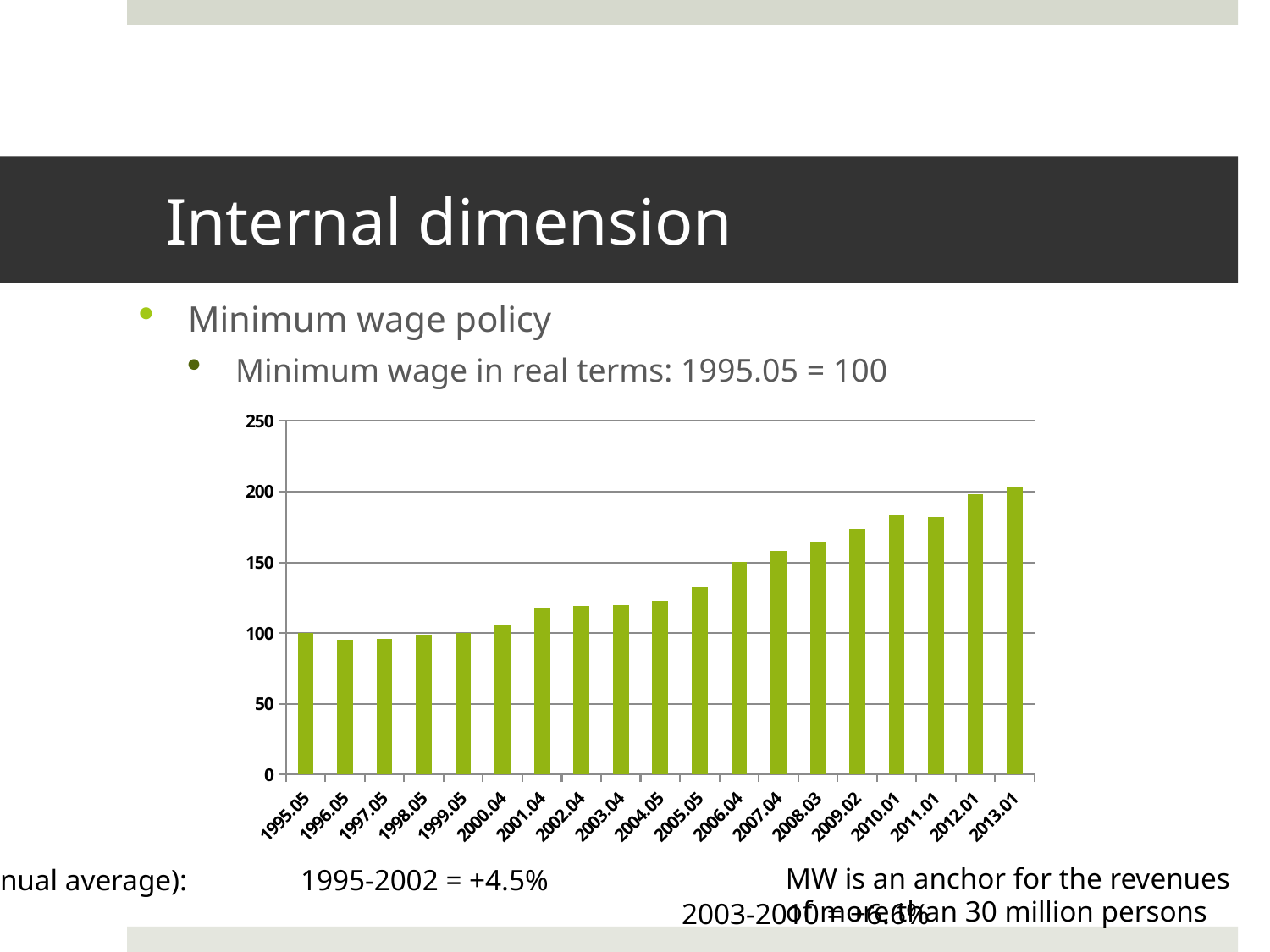
Which time point has the highest bar in the chart? 2013.01 Which is larger, the value for 2008.03 or the value for 2009.02? 2009.02 Which is larger, the value for 2005.05 or the value for 2006.04? 2006.04 Is the value for 2009.02 greater or less than 200? less What is the highest tick value shown on the vertical axis? 250 Is the value for 2005.05 greater or less than 150? less Do the values generally rise or fall from 1995.05 to 2013.01? rise How many bars (time points) are plotted in the chart? 19 What is the value of the minimum wage index for 1995.05? 100 What kind of chart is shown on the slide? bar chart Is the value for 2010.01 greater or less than 150? greater